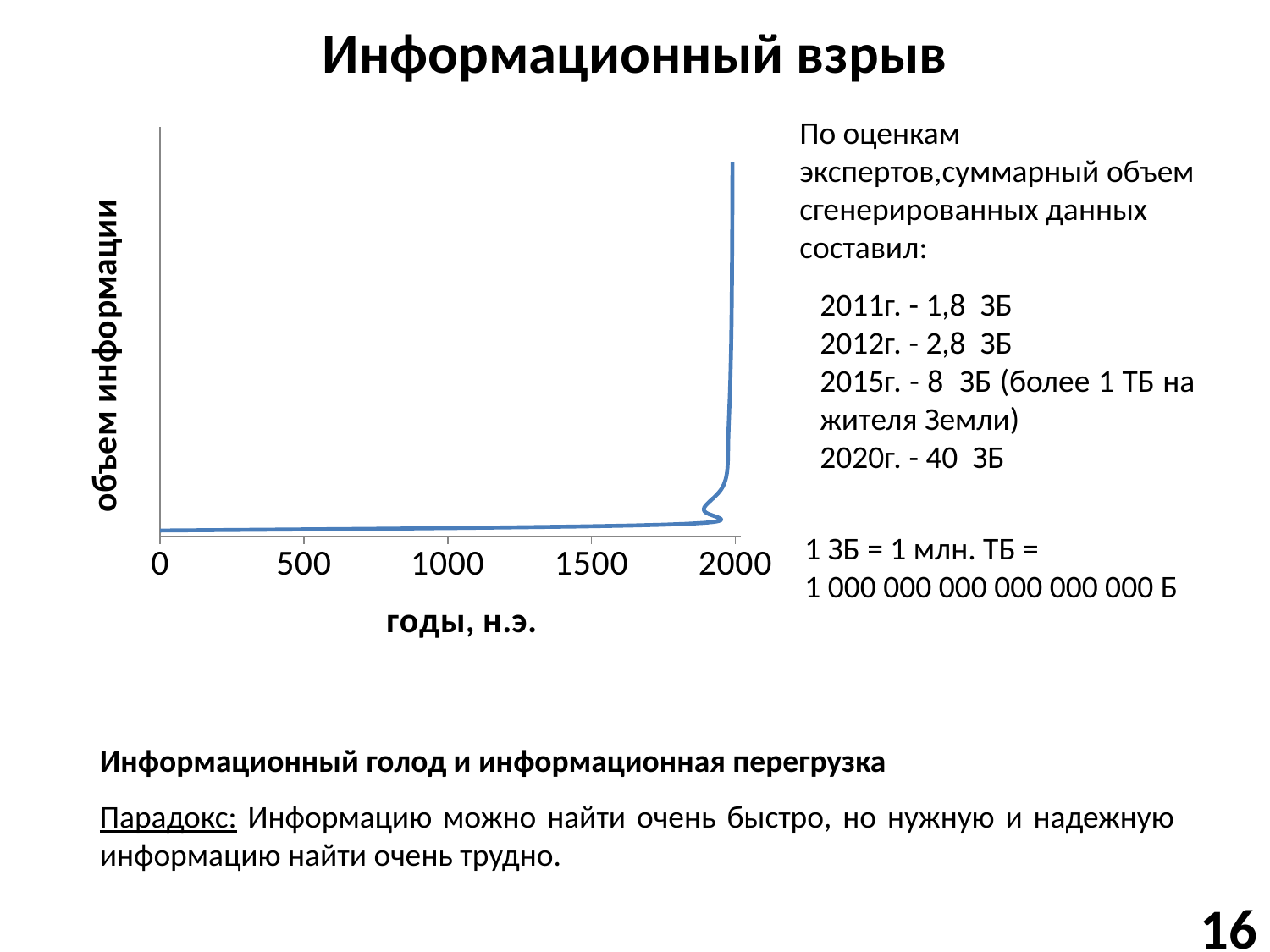
How many tick labels are shown on the x axis? 5 What is the title of the x axis of the chart? годы, н.э. How many lines (data series) are plotted on the chart? 1 What kind of chart is shown on the slide? line chart What is the largest tick value shown on the x axis? 2000 What is the title of the y axis of the chart? объем информации Does the sharp upward spike of the line occur before or after the year 1500 on the x axis? after Does the plotted line rise or fall as the years increase along the x axis? rise